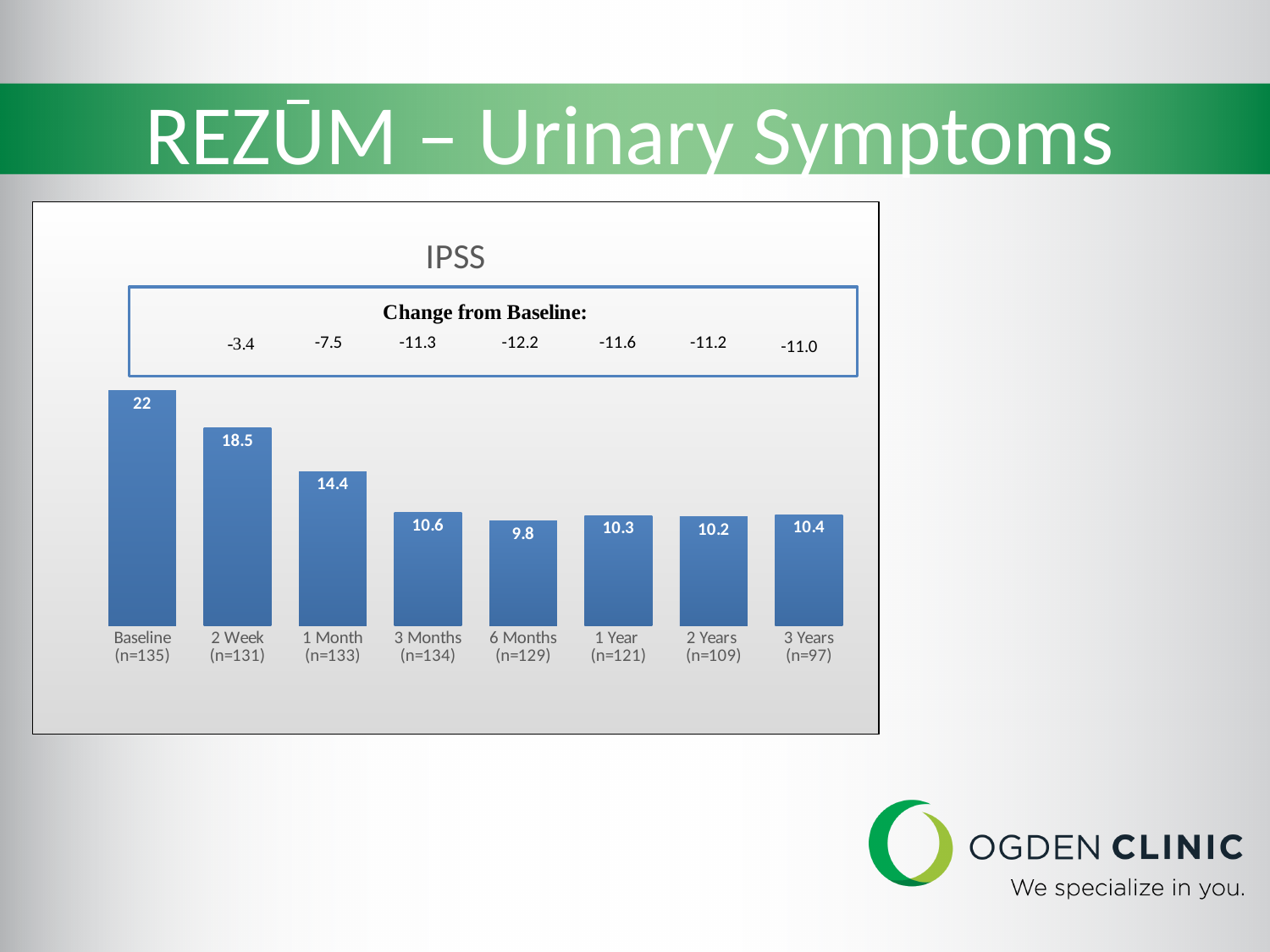
How many time points are shown in the chart? 8 Do the IPSS values rise or fall from Baseline to 6 Months? Fall Which time point has the lowest IPSS value? 6 Months What is the difference between the IPSS value at 1 Month and at 3 Months? 3.8 What is the IPSS value at 6 Months? 9.8 What is the IPSS value at 3 Years? 10.4 What is the IPSS value at Baseline? 22 Which has a larger IPSS value, 2 Week or 1 Month? 2 Week What is the change from baseline shown for 6 Months? -12.2 Which time point has the highest IPSS value? Baseline What kind of chart is shown on the slide? Bar chart What is the difference between the IPSS value at Baseline and at 2 Week? 3.5